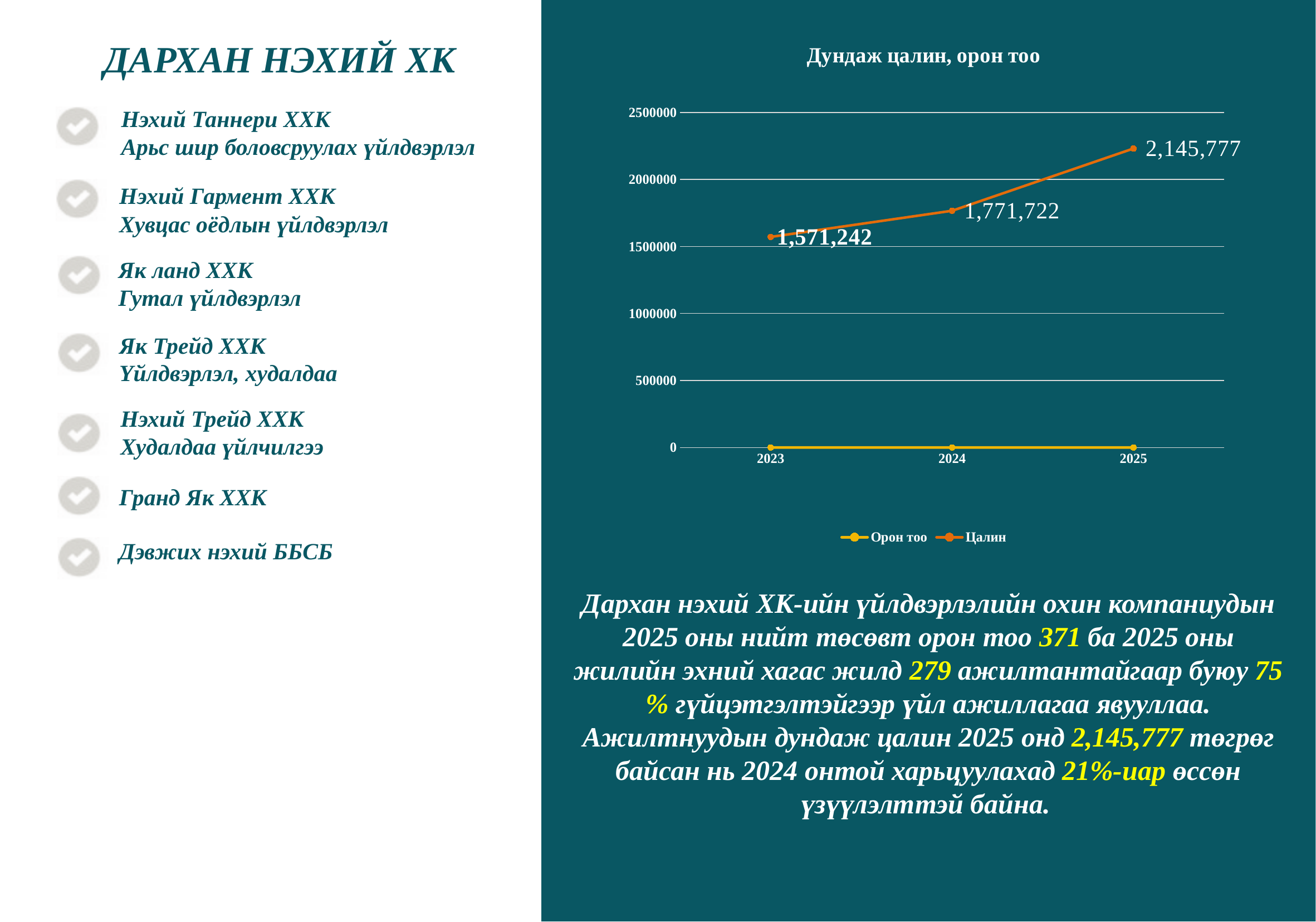
How many years are shown on the x axis? 3 Is the Цалин value for 2025 greater or less than 2000000? greater What is the Цалин value for 2024? 1,771,722 In which year is the Цалин value lowest? 2023 What is the difference between the Цалин values for 2024 and 2023? 200,480 How many series does the legend list? 2 What is the Цалин value for 2023? 1,571,242 Which year has the larger Цалин value, 2023 or 2025? 2025 In which year is the Цалин value highest? 2025 What is the difference between the Цалин values for 2025 and 2024? 374,055 What kind of chart is shown on the slide? Line chart What is the Цалин value for 2025? 2,145,777